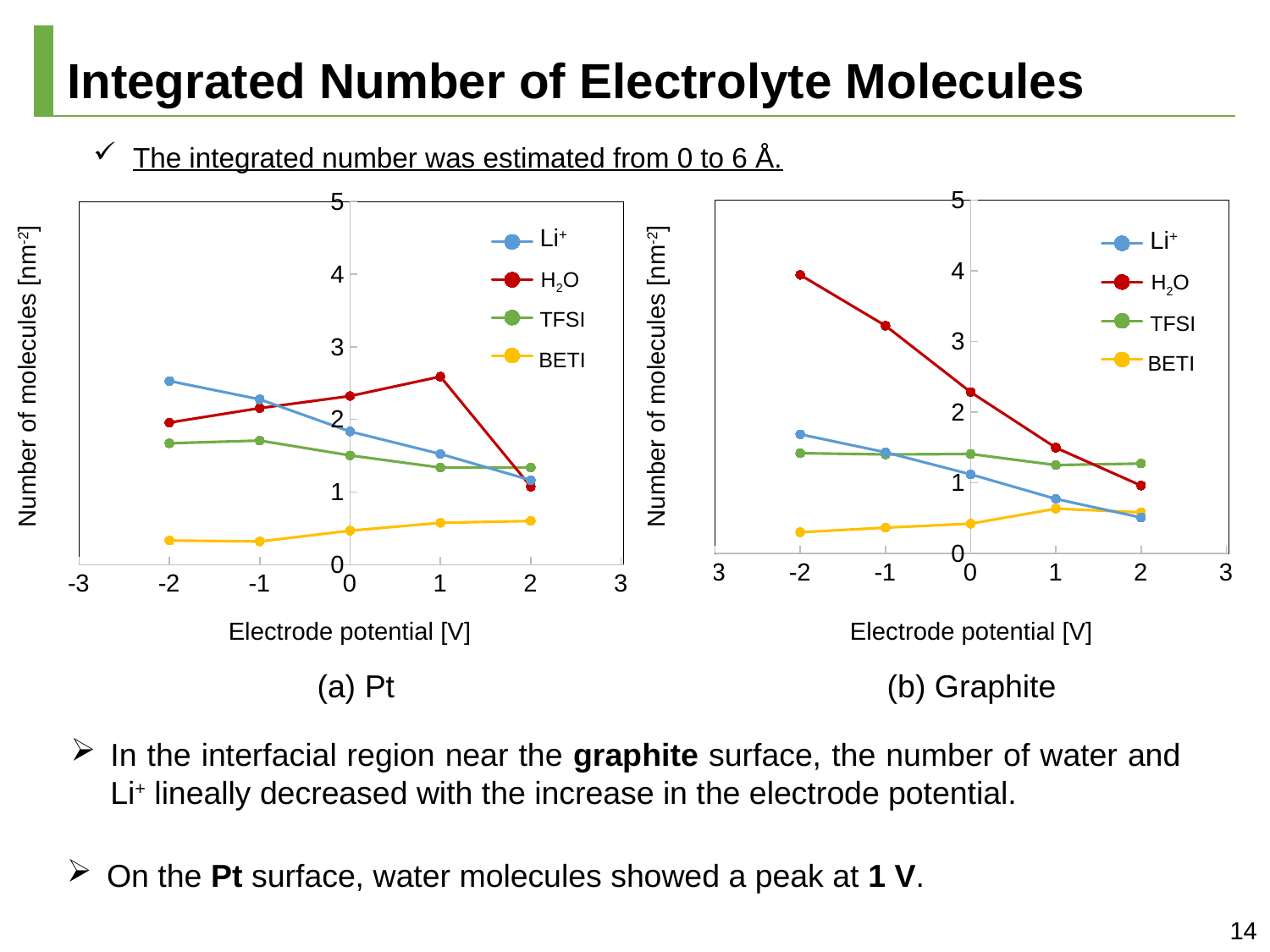
In chart (a) Pt, how many data points does the Li+ series have? 5 What kind of chart is chart (a) Pt? line chart In chart (b) Graphite, how many series does the legend list? 4 In chart (b) Graphite, does the Li+ series rise or fall as the electrode potential increases? fall In chart (a) Pt, at 1 V, which is larger: H2O or Li+? H2O In chart (a) Pt, is the value for Li+ at -2 V greater or less than 2? greater In chart (b) Graphite, which series has the highest value at -2 V? H2O In chart (a) Pt, is the value for BETI at -2 V greater or less than 1? less In chart (a) Pt, which series has the lowest value at 1 V? BETI What is the x-axis label of chart (b) Graphite? Electrode potential [V] In chart (b) Graphite, is the value for H2O at -2 V greater or less than 3? greater In chart (b) Graphite, does the H2O series rise or fall as the electrode potential increases? fall